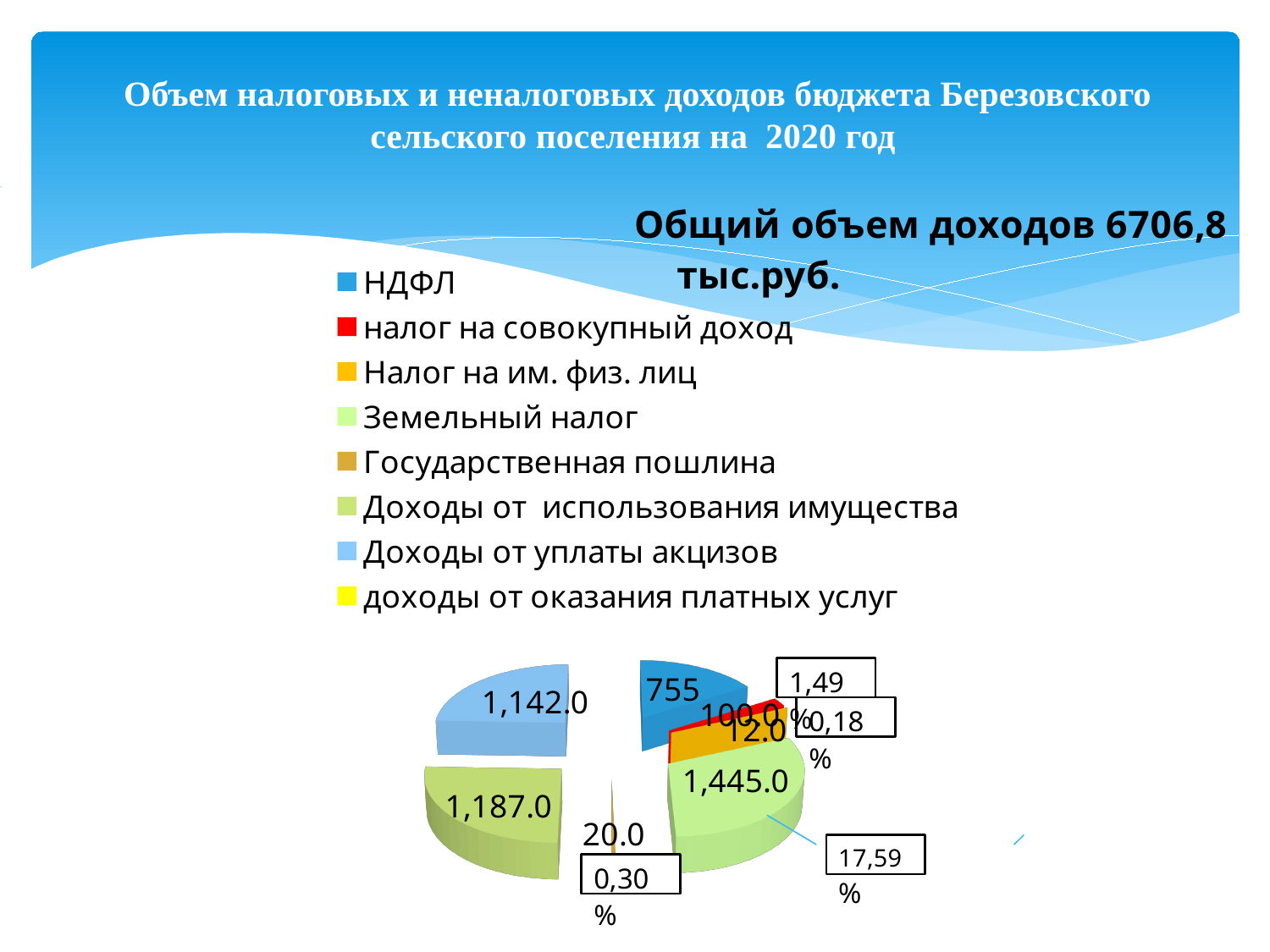
What value is shown for Земельный налог on the pie chart? 1,445.0 Which is larger: Доходы от использования имущества or Доходы от уплаты акцизов? Доходы от использования имущества What value is shown for Доходы от уплаты акцизов on the pie chart? 1,142.0 What value is shown for Государственная пошлина on the pie chart? 20.0 What value is shown for НДФЛ on the pie chart? 755 Which category has the largest slice of the pie chart? Земельный налог What value is shown for Доходы от использования имущества on the pie chart? 1,187.0 What total income volume is stated on the slide? 6706,8 тыс.руб. What is the difference between the values for Земельный налог and Доходы от использования имущества? 258.0 How many entries does the legend of the pie chart list? 8 What colour represents НДФЛ in the legend? blue What kind of chart is shown on the slide? pie chart